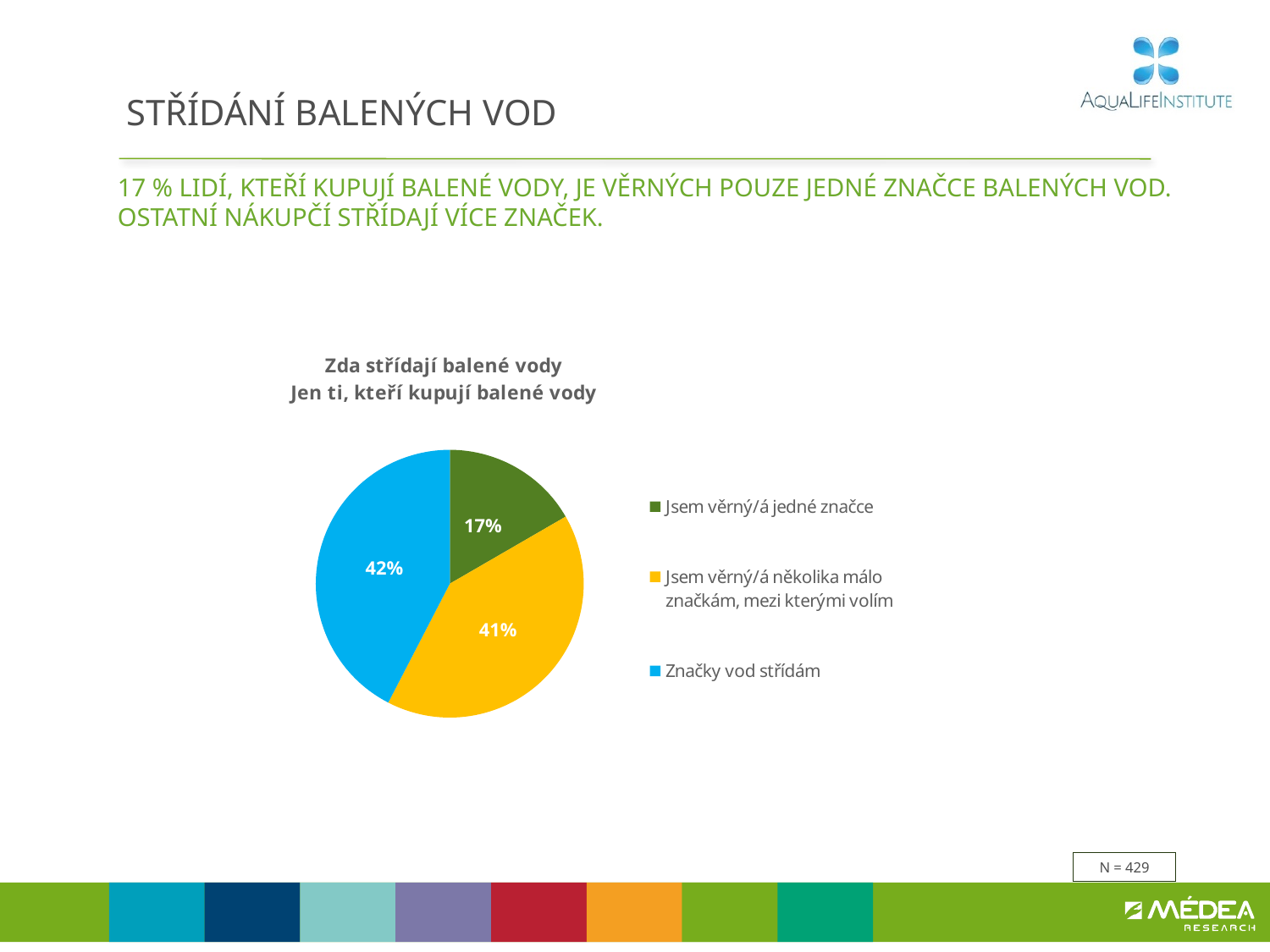
What is the difference in percentage points between "Značky vod střídám" and "Jsem věrný/á jedné značce"? 25 percentage points What is the title of the pie chart? Zda střídají balené vody Jen ti, kteří kupují balené vody Which category has the largest slice of the pie? Značky vod střídám What share of the pie is labelled "Jsem věrný/á jedné značce"? 17% Which is larger: the slice for "Jsem věrný/á jedné značce" or the slice for "Jsem věrný/á několika málo značkám, mezi kterými volím"? Jsem věrný/á několika málo značkám, mezi kterými volím What type of chart is shown on the slide? pie chart How many slices does the pie chart have? 3 What colour is the slice for "Značky vod střídám"? blue What share of the pie is labelled "Jsem věrný/á několika málo značkám, mezi kterými volím"? 41% What share of the pie is labelled "Značky vod střídám"? 42% Which category has the smallest slice of the pie? Jsem věrný/á jedné značce How many entries does the legend list? 3